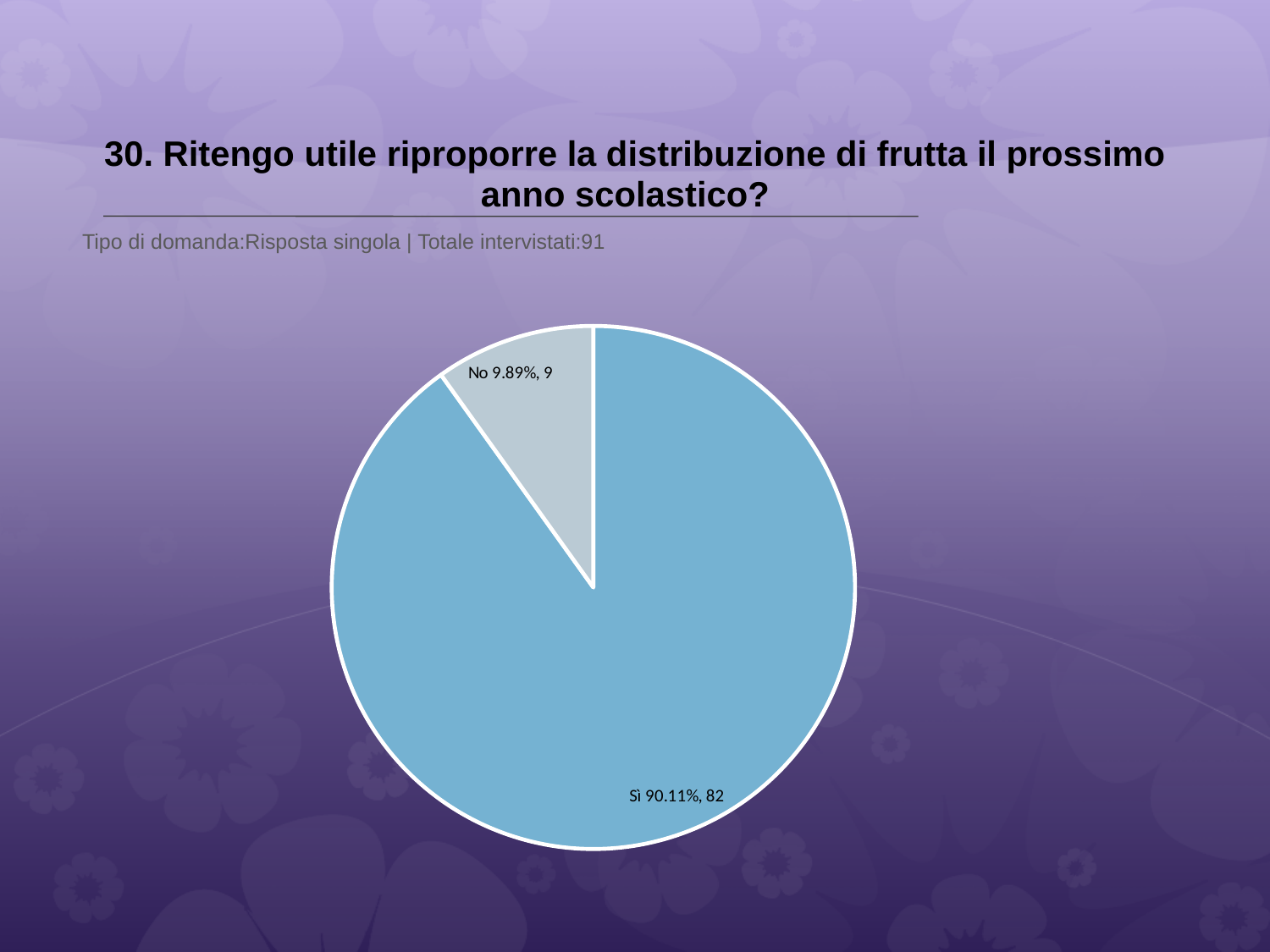
Which has more respondents, "Sì" or "No"? Sì What kind of chart is shown on the slide? pie chart What is the total number of respondents across both slices? 91 How many respondents answered "Sì"? 82 How many respondents answered "No"? 9 Which slice is the largest in the pie chart? Sì Which slice is the smallest in the pie chart? No What is the title of the chart on the slide? 30. Ritengo utile riproporre la distribuzione di frutta il prossimo anno scolastico? How many slices does the pie chart have? 2 What percentage is shown for the "Sì" slice? 90.11% What percentage is shown for the "No" slice? 9.89% What is the difference in respondent counts between "Sì" and "No"? 73